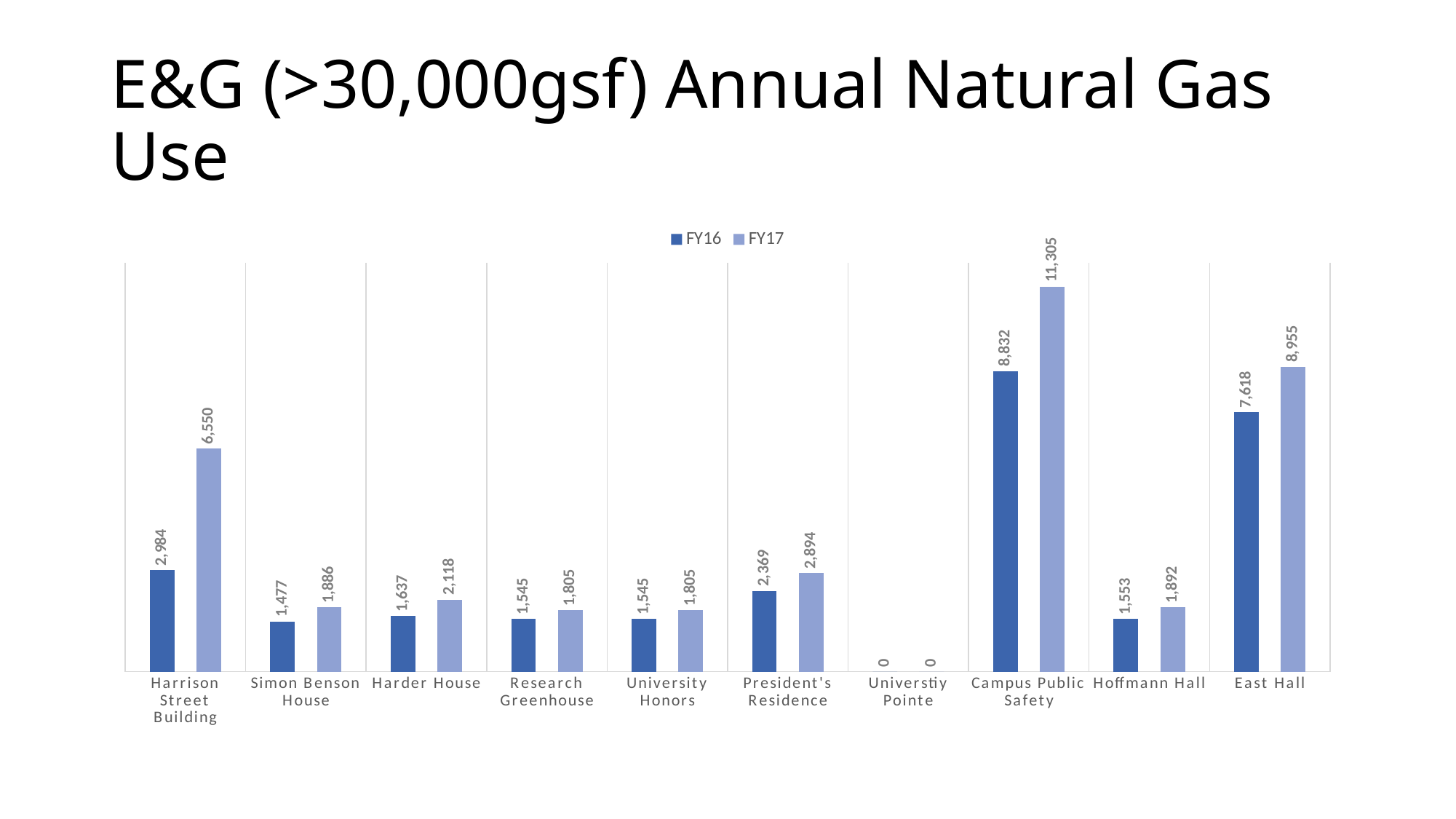
Which is larger, the FY16 value for Harder House or the FY16 value for Simon Benson House? Harder House Which building has the highest FY17 value? Campus Public Safety What are the two series listed in the legend? FY16 and FY17 How many series does the legend list? 2 What is the FY17 value for Harrison Street Building? 6,550 What is the difference between the FY17 and FY16 values for East Hall? 1,337 How many buildings are shown on the x axis? 10 Which building has the lowest FY16 value? Universtiy Pointe What kind of chart is shown on the slide? Bar chart What is the difference between the FY17 and FY16 values for Campus Public Safety? 2,473 What is the FY16 value for Campus Public Safety? 8,832 What is the FY17 value for Hoffmann Hall? 1,892